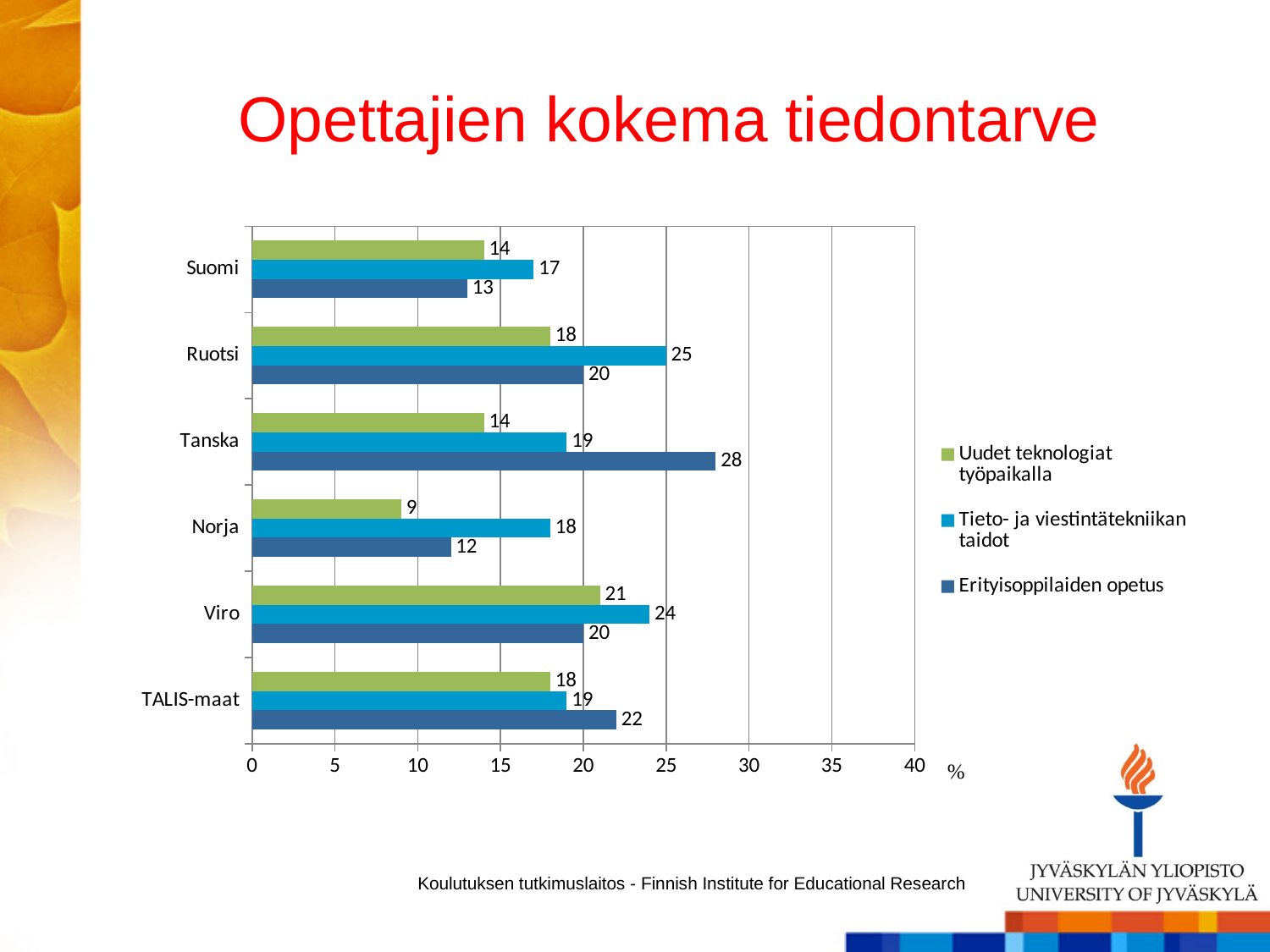
What is the value for Tanska in the Erityisoppilaiden opetus series? 28 Which category has the highest value in the Tieto- ja viestintätekniikan taidot series? Ruotsi What is the title of the slide containing the chart? Opettajien kokema tiedontarve How many categories are shown on the y axis of the chart? 6 What kind of chart is shown on the slide? Bar chart Is the Erityisoppilaiden opetus value for TALIS-maat greater or less than 20? greater Which is larger for Viro: the Uudet teknologiat työpaikalla value or the Tieto- ja viestintätekniikan taidot value? Tieto- ja viestintätekniikan taidot Which category has the lowest value in the Uudet teknologiat työpaikalla series? Norja How many series does the legend list? 3 What is the value for Suomi in the Tieto- ja viestintätekniikan taidot series? 17 What is the difference between the Erityisoppilaiden opetus values for Tanska and Suomi? 15 What is the value for Norja in the Uudet teknologiat työpaikalla series? 9